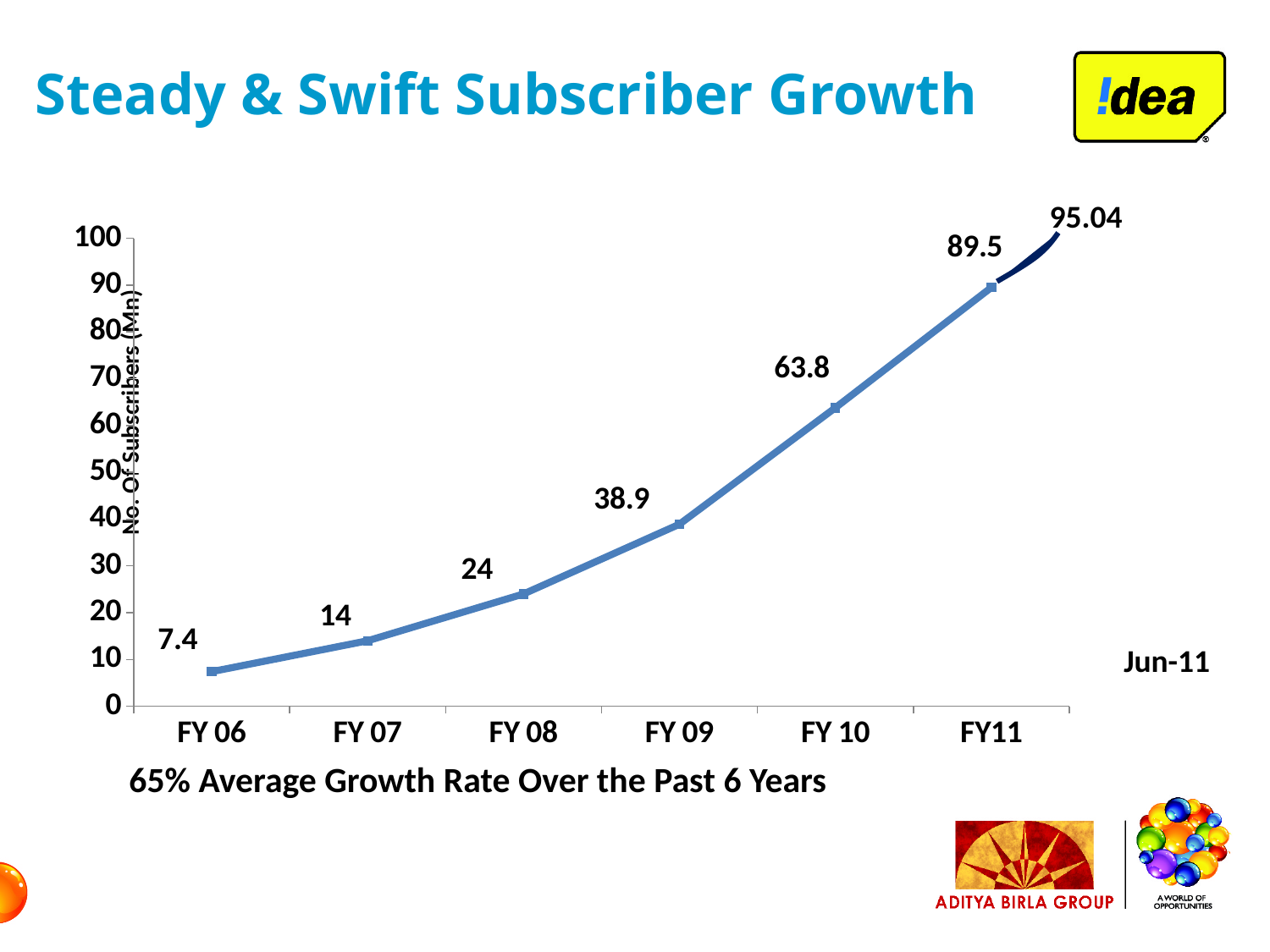
What kind of chart is shown on the slide? line chart What is the difference in subscribers (Mn) between FY11 and FY 10? 25.7 Which fiscal year on the x axis has the highest number of subscribers? FY11 What is the difference in subscribers (Mn) between FY 09 and FY 08? 14.9 Which fiscal year has the lowest number of subscribers? FY 06 What is the number of subscribers (Mn) for FY 06? 7.4 How many fiscal years are labelled on the x axis? 6 What is the number of subscribers (Mn) for FY 08? 24 What is the number of subscribers (Mn) for FY 10? 63.8 Do the subscriber numbers rise or fall from FY 06 to FY11? rise What value is labelled for Jun-11? 95.04 Which has more subscribers, FY 07 or FY 09? FY 09